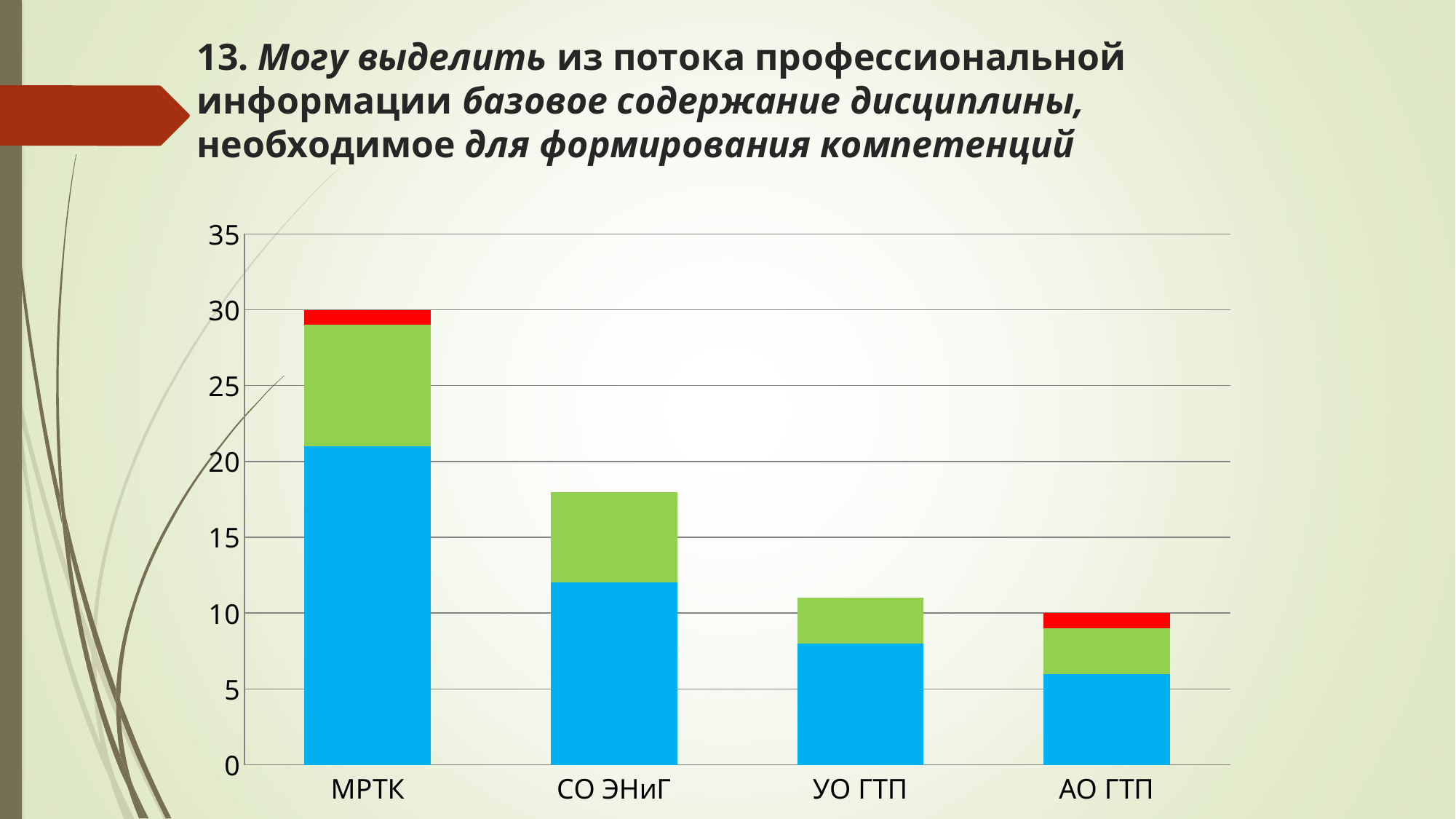
Is the blue segment for УО ГТП greater or less than 10? less Which category has the tallest stacked bar? МРТК What kind of chart is shown on the slide? stacked bar chart What is the total height of the stacked bar for АО ГТП? 10 Is the total value for УО ГТП greater or less than 15? less Which stacked bar is taller, СО ЭНиГ or УО ГТП? СО ЭНиГ What is the total height of the stacked bar for МРТК? 30 Do the total bar heights rise or fall from left to right along the x axis? fall How many categories are shown on the x axis of the chart? 4 Which categories have a red segment at the top of their bar? МРТК and АО ГТП Which category has the shortest stacked bar? АО ГТП Is the total value for СО ЭНиГ greater or less than 15? greater